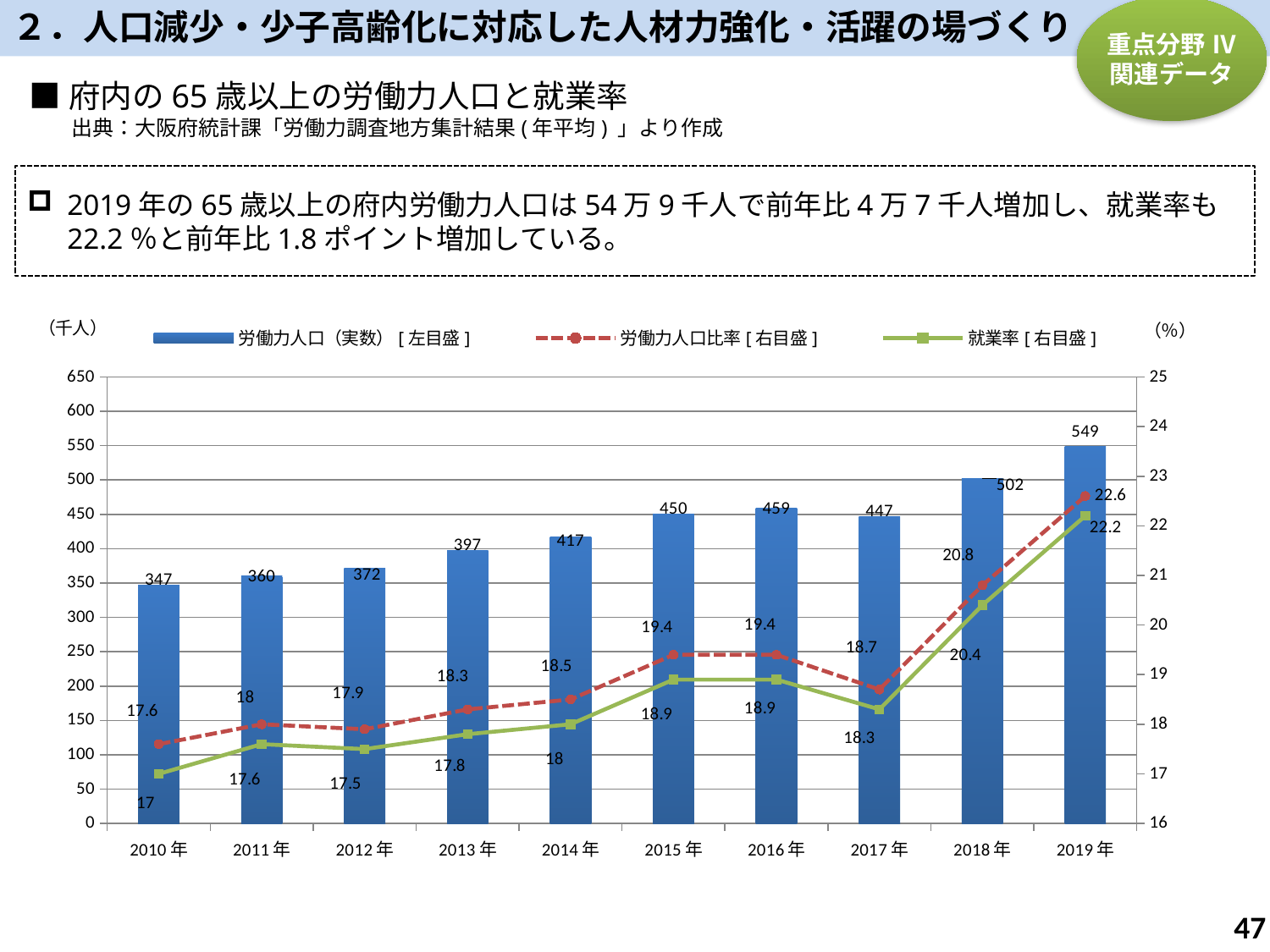
就業率の系列は何色の線で示されていますか？ 緑 2010年から2014年にかけて、労働力人口（実数）は増加していますか、減少していますか？ 増加 労働力人口（実数）が最も少ない年はどれですか？ 2010年 2018年の労働力人口比率の値はいくつですか？ 20.8 2015年の就業率の値はいくつですか？ 18.9 横軸には何年分のデータが示されていますか？ 10 2017年の労働力人口（実数）と2016年の労働力人口（実数）では、どちらが大きいですか？ 2016年 凡例にはいくつの系列が示されていますか？ 3 2019年の労働力人口（実数）の値はいくつですか？ 549 就業率が最も高い年はどれですか？ 2019年 2013年の労働力人口（実数）は400より大きいですか、小さいですか？ 小さい 2019年と2018年の労働力人口（実数）の差はいくつですか？ 47